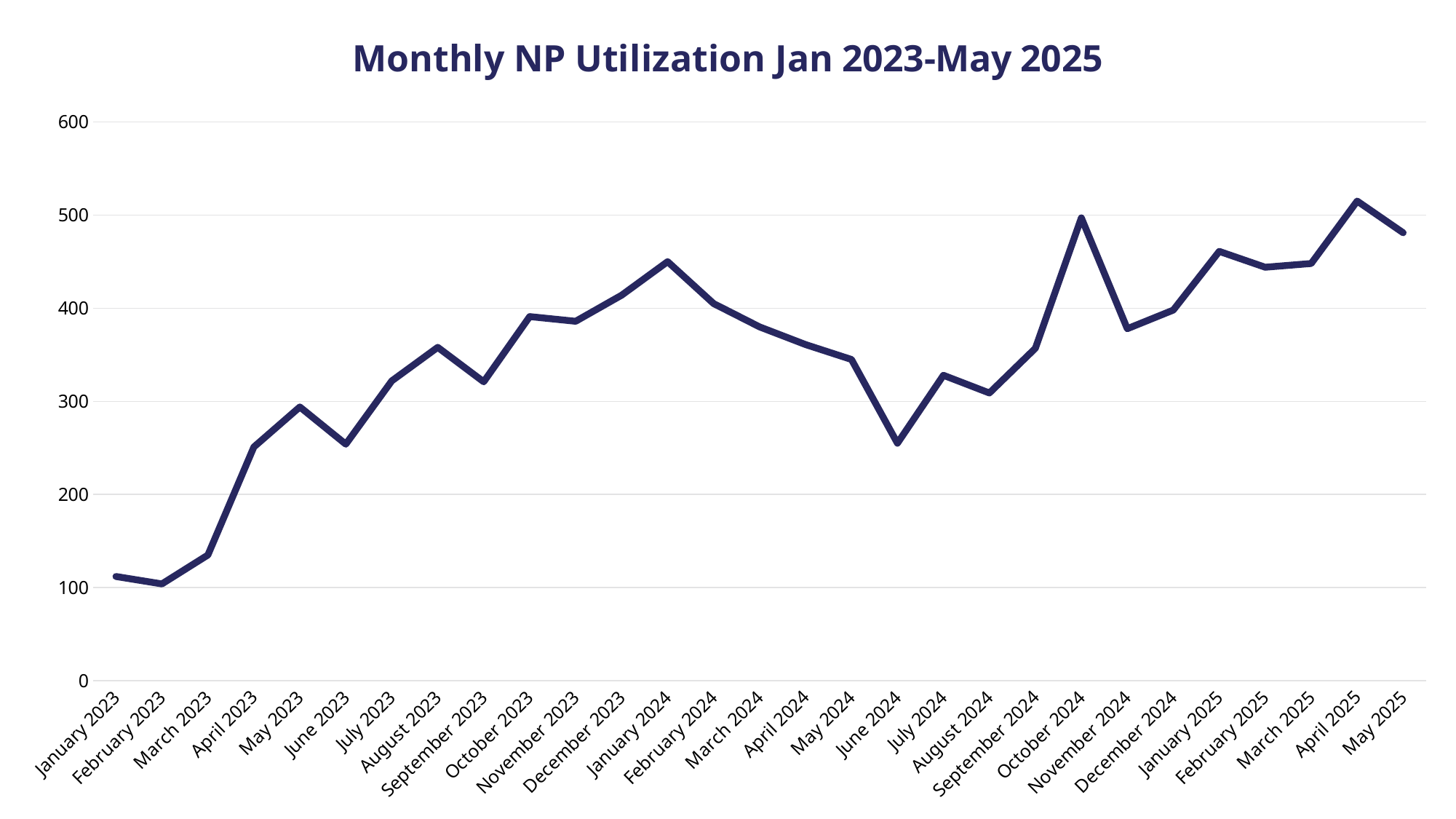
What kind of chart is shown on the slide? line chart What is the title of the chart? Monthly NP Utilization Jan 2023-May 2025 How many monthly data points are plotted on the chart? 29 Which is larger, the value for October 2024 or November 2024? October 2024 Overall, does NP utilization rise or fall from January 2023 to May 2025? rise Is the value for November 2024 greater or less than 400? less Which is larger, the value for April 2023 or April 2024? April 2024 Is the value for February 2023 greater or less than 200? less Is the value for January 2024 greater or less than 400? greater Which month has the highest NP utilization? April 2025